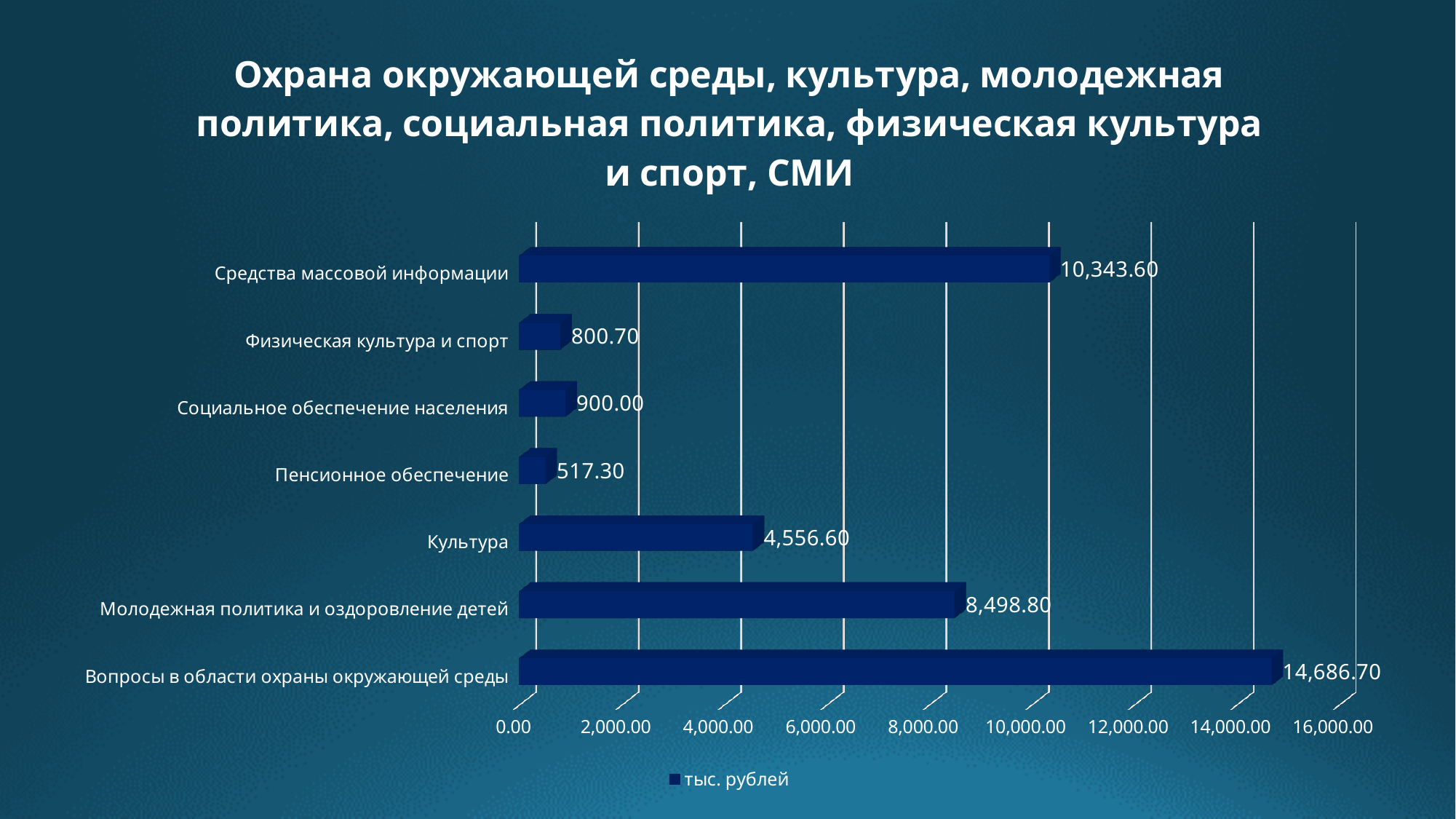
What is the value for Молодежная политика и оздоровление детей? 8,498.80 Which category has the highest value? Вопросы в области охраны окружающей среды How many categories are shown in the chart? 7 Is the value for Вопросы в области охраны окружающей среды greater or less than 14,000.00? greater What is the value for Пенсионное обеспечение? 517.30 Which category has the lowest value? Пенсионное обеспечение What series name does the legend show? тыс. рублей What is the value for Культура? 4,556.60 What is the difference between the values for Социальное обеспечение населения and Физическая культура и спорт? 99.30 What is the value for Средства массовой информации? 10,343.60 Which is larger, the value for Средства массовой информации or the value for Молодежная политика и оздоровление детей? Средства массовой информации What kind of chart is shown on the slide? bar chart